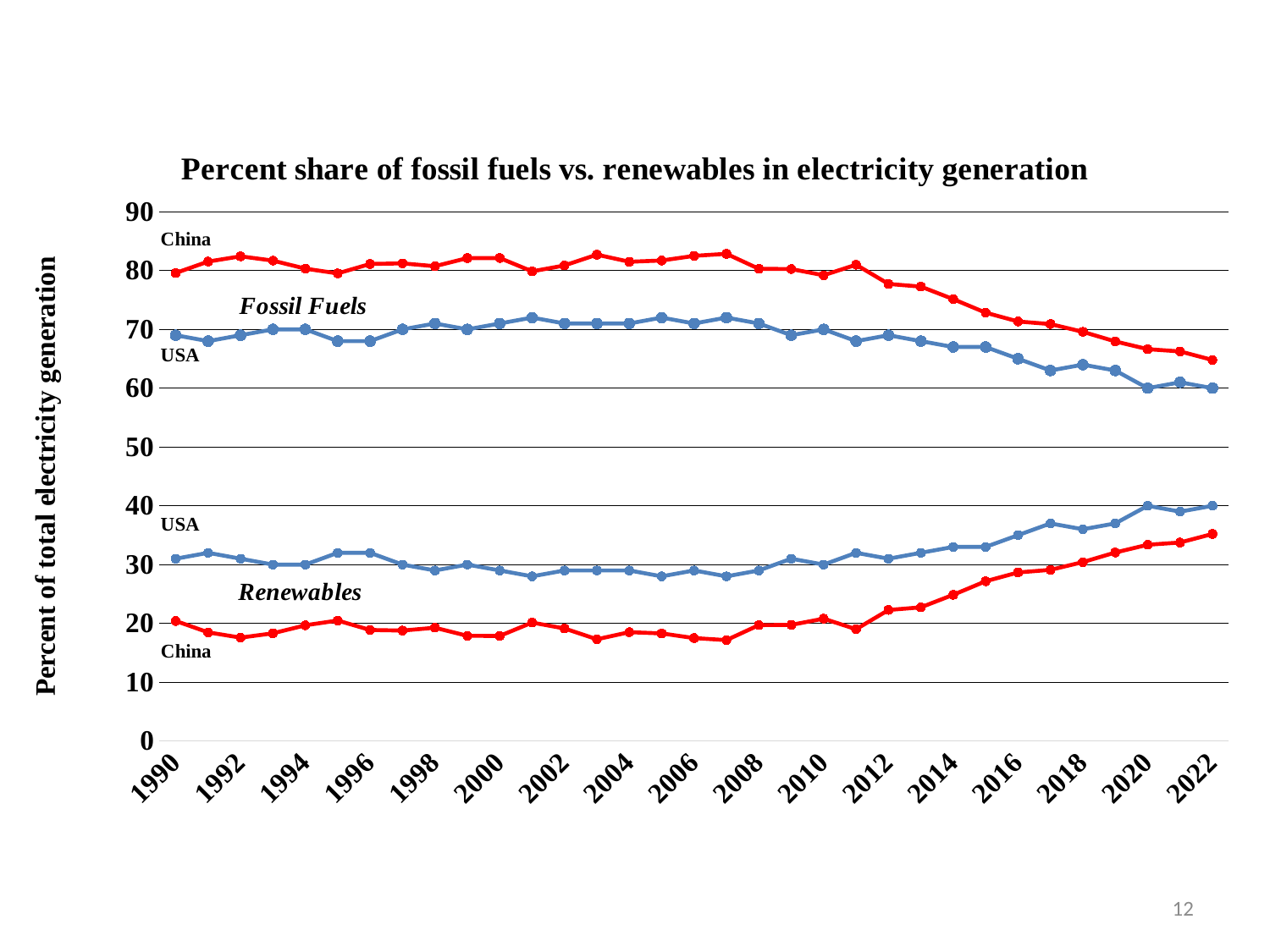
Does the China Fossil Fuels line rise or fall between 2011 and 2022? fall In 2022, which country has the larger share of renewables in electricity generation, China or the USA? USA What kind of chart is shown on the slide? line chart Is the value for China Fossil Fuels in 2007 greater or less than 80? greater Is the value for China Renewables in 1990 greater or less than 30? less What is the label on the vertical axis of the chart? Percent of total electricity generation Is the value for USA Fossil Fuels in 2000 greater or less than 80? less What is the title of the chart? Percent share of fossil fuels vs. renewables in electricity generation How many years are labeled on the x axis of the chart? 17 In 1990, which country has the larger share of fossil fuels in electricity generation, China or the USA? China